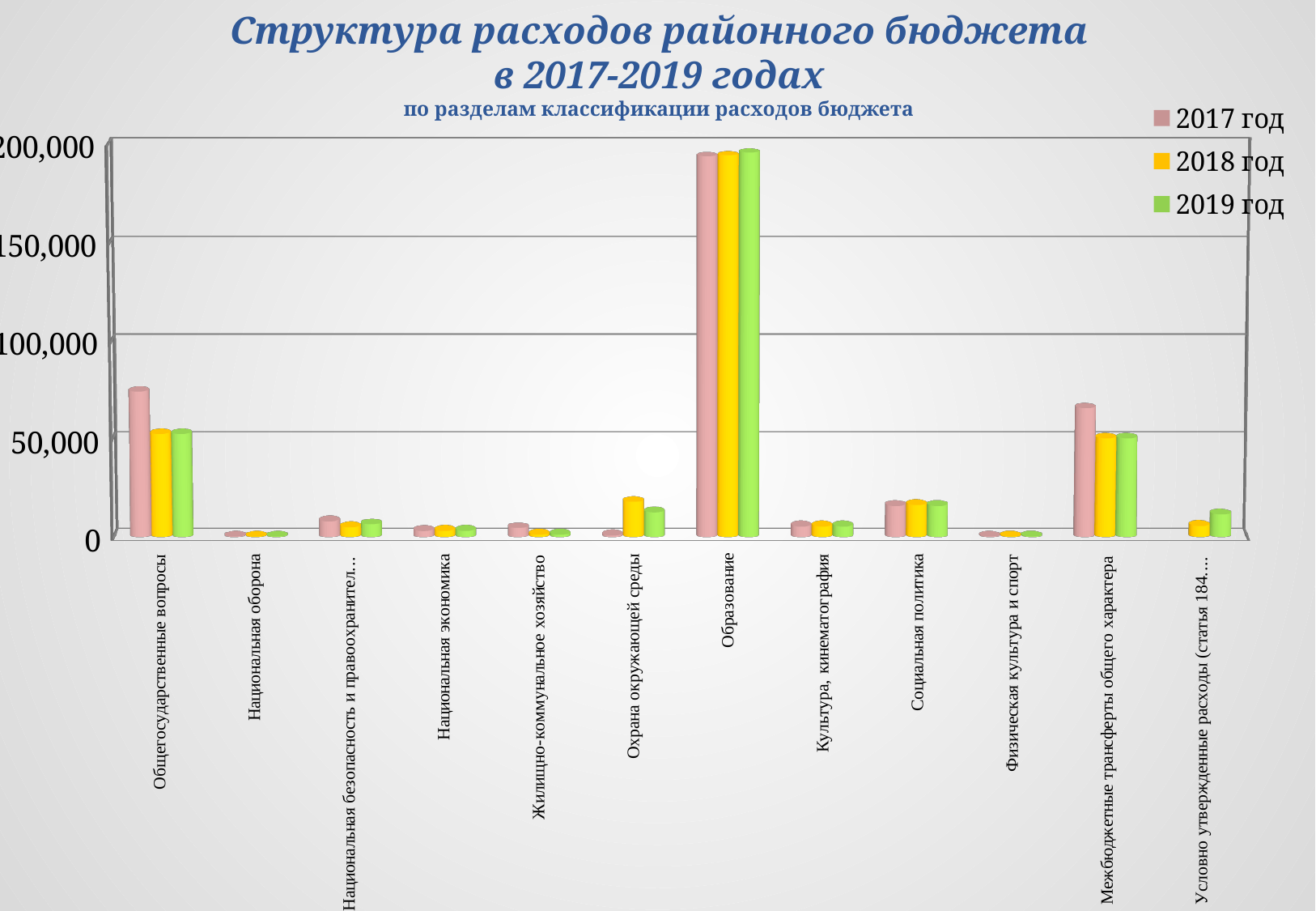
Is the value for Общегосударственные вопросы in 2017 год greater or less than 50,000? greater What are the three entries listed in the legend? 2017 год, 2018 год, 2019 год Which category has the highest value for 2017 год? Образование How many series does the legend list? 3 How many expenditure categories are shown along the x axis? 12 For Охрана окружающей среды, which is larger: the value for 2017 год or for 2018 год? 2018 год For Условно утвержденные расходы, which is larger: the value for 2018 год or for 2019 год? 2019 год Is the value for Образование in 2019 год greater or less than 150,000? greater Is the value for Социальная политика in 2019 год greater or less than 50,000? less What kind of chart is shown on the slide? Bar chart For Общегосударственные вопросы, which is larger: the value for 2017 год or for 2018 год? 2017 год